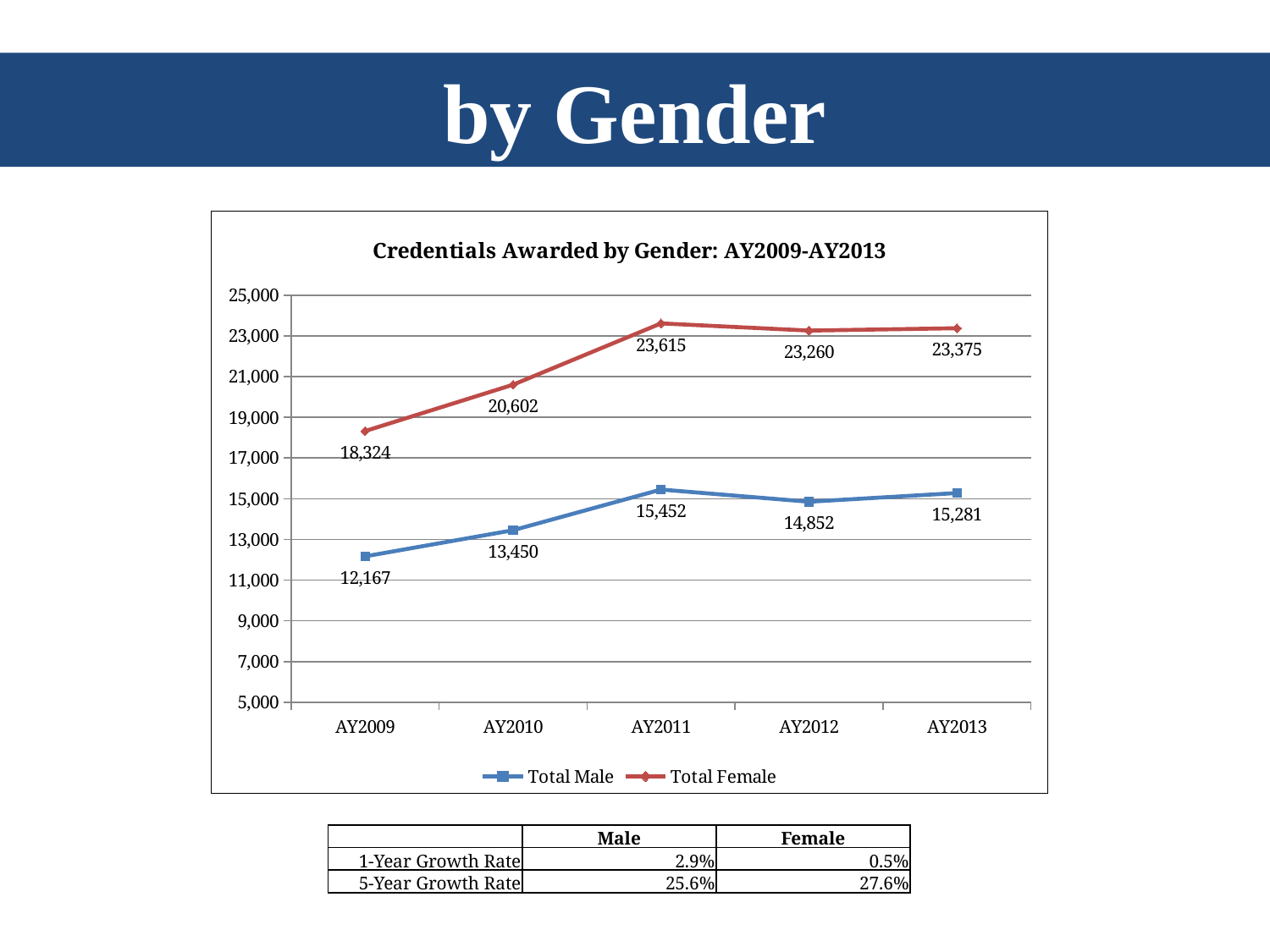
What is the value for Total Female in AY2011? 23,615 What kind of chart is shown? Line chart How many academic years are shown on the x axis? 5 Which is larger: Total Male in AY2011 or Total Male in AY2013? Total Male in AY2011 What is the value for Total Male in AY2009? 12,167 What is the difference between Total Female and Total Male in AY2013? 8,094 Is the value for Total Female in AY2009 greater or less than 17,000? greater What is the value for Total Male in AY2012? 14,852 In which year is the Total Male value lowest? AY2009 How many series does the legend list? 2 What is the title of the chart? Credentials Awarded by Gender: AY2009-AY2013 In which year is the Total Female value highest? AY2011